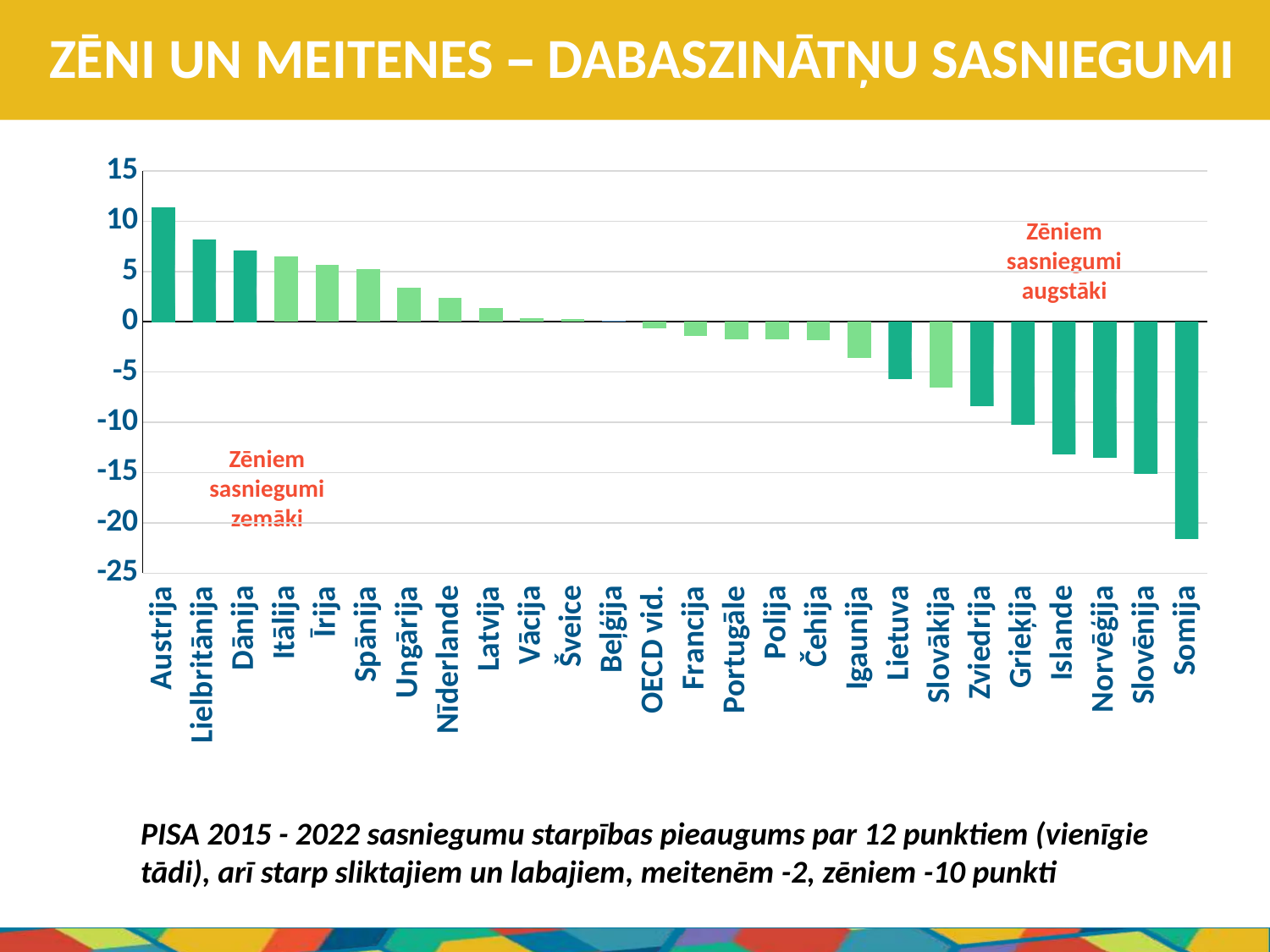
What kind of chart is shown on the slide? Bar chart Do the values rise or fall moving from left to right along the x axis? Fall How many countries/categories are shown on the x axis of the chart? 26 Is the value for Igaunija greater or less than -5? greater Is the value for Austrija greater or less than 10? greater Is the value for Somija greater or less than -20? less Which country has the lowest value in the chart? Somija Which has the lower value, Somija or Slovēnija? Somija Which country has the highest value in the chart? Austrija Which has the larger value, Austrija or Lielbritānija? Austrija